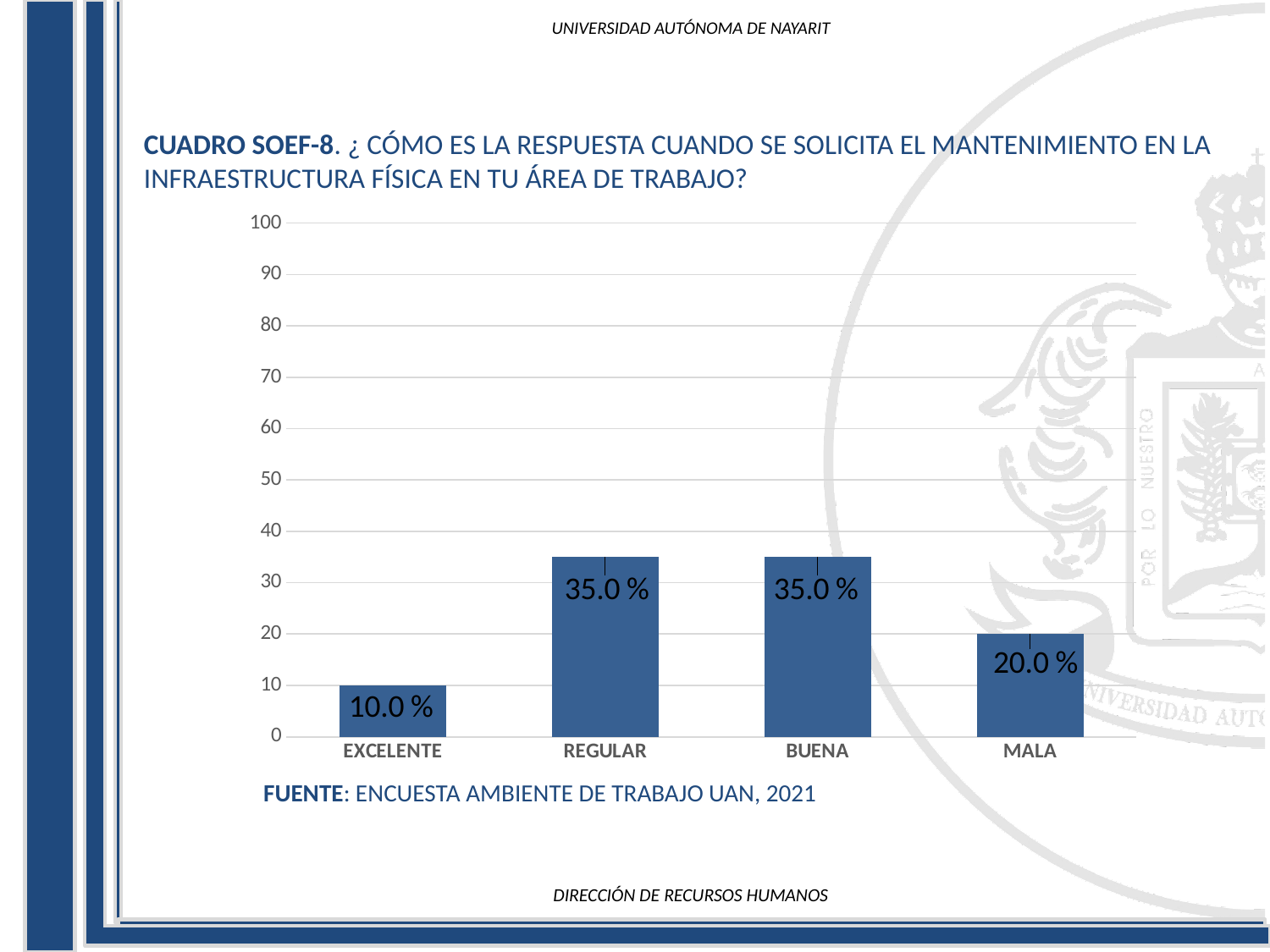
What is the source cited below the chart? ENCUESTA AMBIENTE DE TRABAJO UAN, 2021 Is the value for BUENA greater or less than 30? greater Which is larger, the value for MALA or the value for EXCELENTE? MALA What is the difference between the values for BUENA and MALA? 15.0 % What is the difference between the values for MALA and EXCELENTE? 10.0 % What is the value for EXCELENTE? 10.0 % How many categories are shown on the x axis? 4 What is the value for MALA? 20.0 % What kind of chart is shown on the slide? bar chart Which category has the lowest value? EXCELENTE What is the highest value shown on the vertical axis? 100 What is the value for REGULAR? 35.0 %